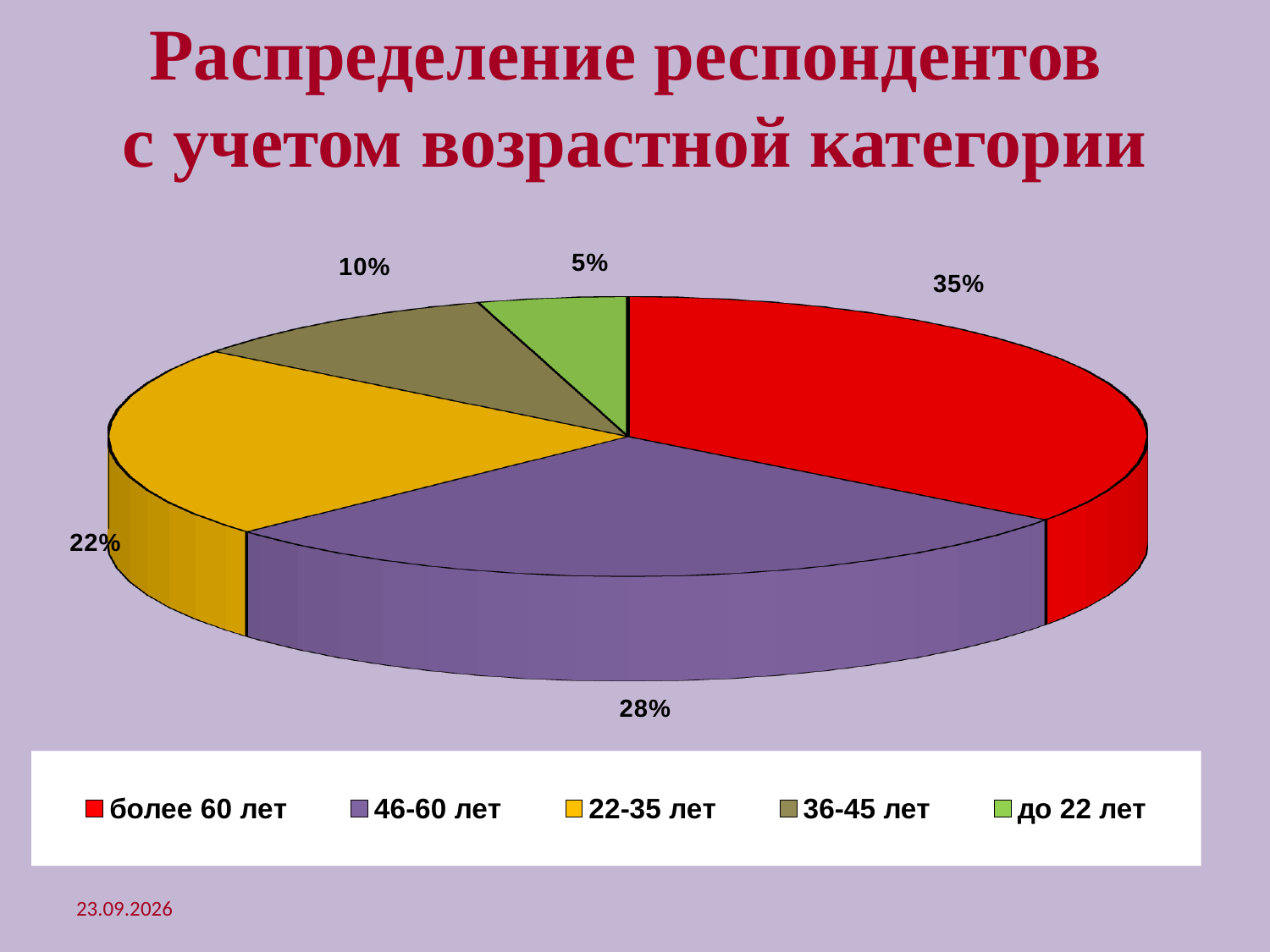
What share of respondents are in the '46-60 лет' category? 28% Which age category has the smallest share of respondents? до 22 лет What share of respondents are in the '22-35 лет' category? 22% What is the difference between the shares for 'более 60 лет' and '46-60 лет'? 7% How many age categories does the pie chart show? 5 Which colour represents the '46-60 лет' category in the legend? purple Which age category has the largest share of respondents? более 60 лет What share of respondents are in the 'более 60 лет' category? 35% What kind of chart is shown on the slide? pie chart What share of respondents are in the 'до 22 лет' category? 5% Which is larger: the share for '22-35 лет' or the share for '36-45 лет'? 22-35 лет What share of respondents are in the '36-45 лет' category? 10%